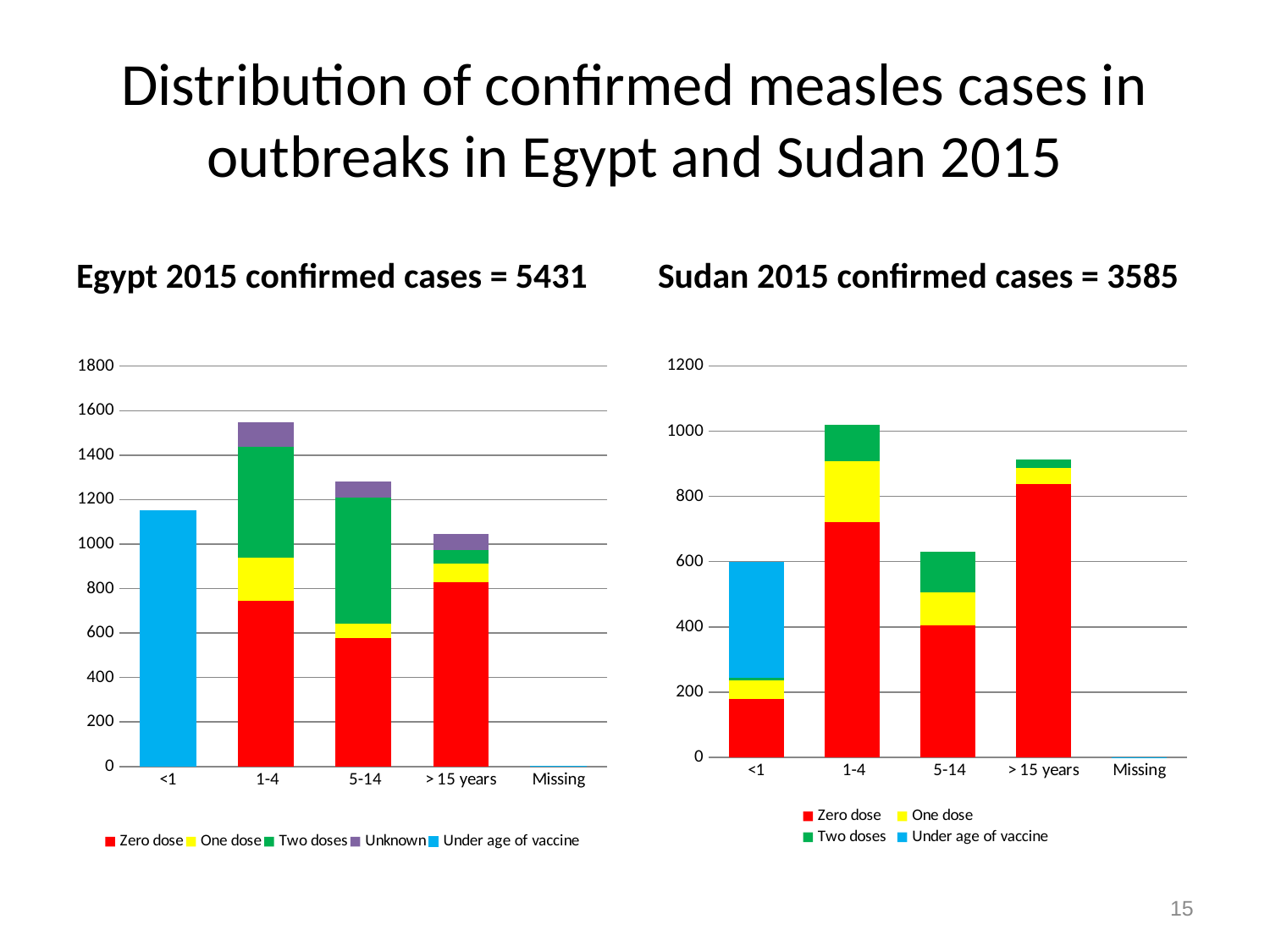
How many series does the legend of the Egypt 2015 confirmed cases chart list? 5 In the Sudan 2015 confirmed cases chart, is the total for the > 15 years age group greater or less than 800? greater In the Sudan 2015 confirmed cases chart, which age category has the tallest stacked bar? 1-4 In the Sudan 2015 confirmed cases chart, is the total for the <1 age group greater or less than 800? less How many age categories are shown on the x axis of the Sudan 2015 confirmed cases chart? 5 In the Egypt 2015 confirmed cases chart, is the total for the <1 age group greater or less than 1000? greater Which legend entry appears in the Egypt 2015 confirmed cases chart but not in the Sudan 2015 confirmed cases chart? Unknown How many series does the legend of the Sudan 2015 confirmed cases chart list? 4 What kind of chart is the Egypt 2015 confirmed cases chart? Stacked bar chart In the Egypt 2015 confirmed cases chart, which age category has the tallest stacked bar? 1-4 In the Egypt 2015 confirmed cases chart, which stacked bar is taller: 5-14 or > 15 years? 5-14